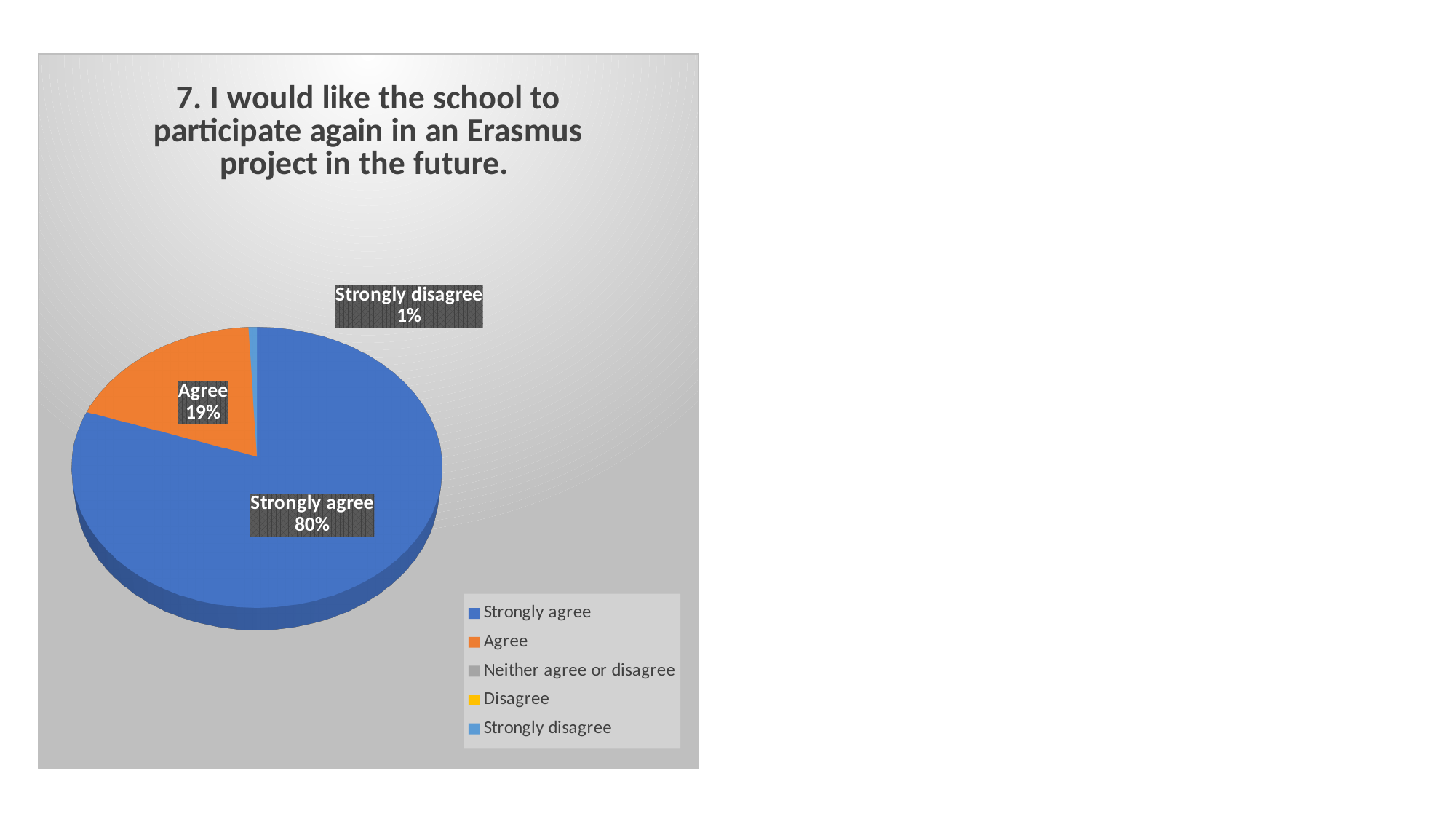
How many slices have a percentage label shown on the chart? 3 What is the title of the chart? 7. I would like the school to participate again in an Erasmus project in the future. Which labelled slice has the smallest share of the pie? Strongly disagree What percentage of respondents chose "Strongly disagree"? 1% How many entries does the legend list? 5 Which response category has the largest share of the pie? Strongly agree What colour is the "Agree" slice? Orange What percentage of respondents chose "Strongly agree"? 80% What percentage of respondents chose "Agree"? 19% What is the difference in percentage points between "Strongly agree" and "Agree"? 61 Which is larger, the share for "Agree" or the share for "Strongly disagree"? Agree What kind of chart is shown on the slide? Pie chart